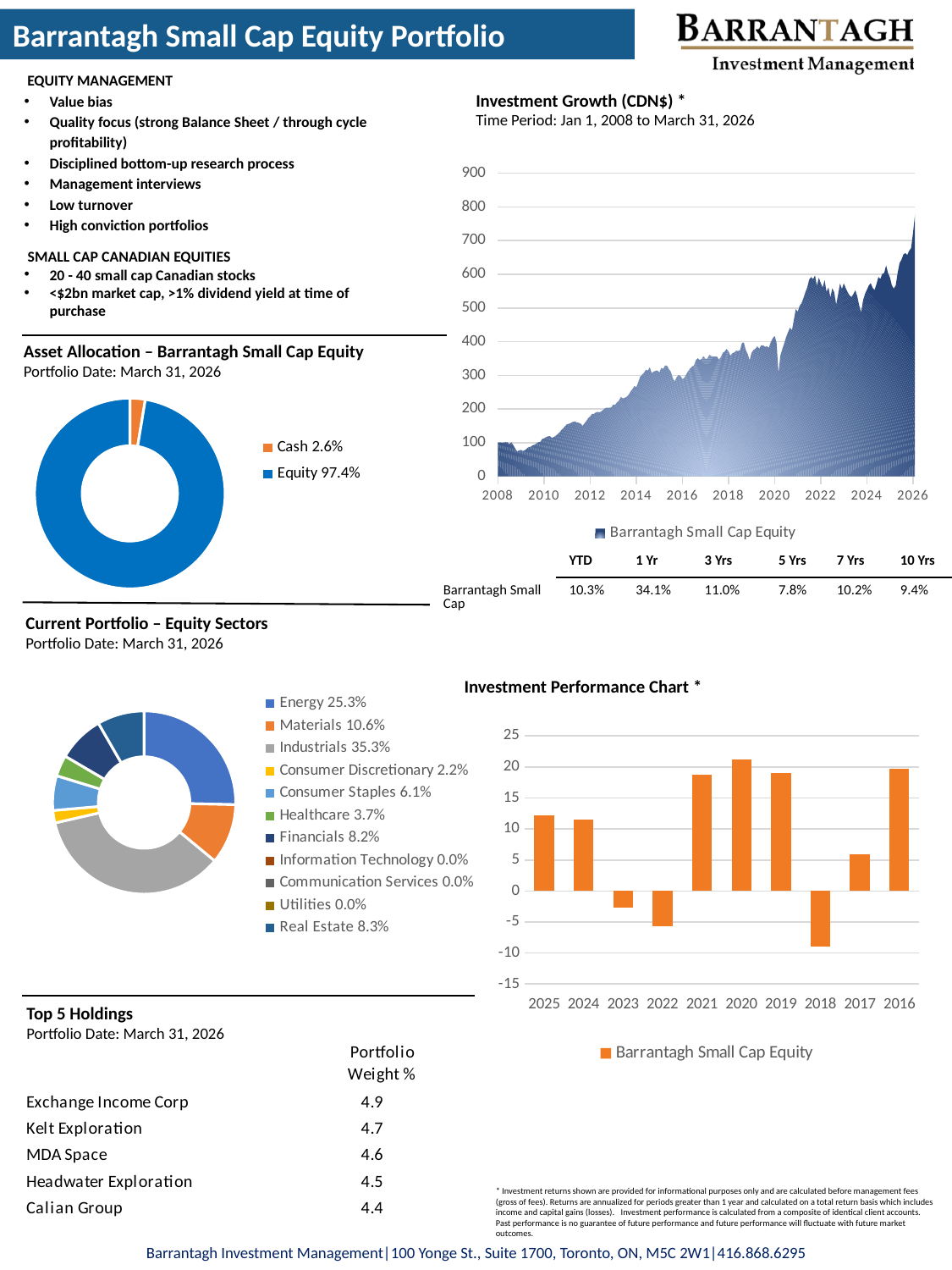
In the Asset Allocation chart, what is the value for Cash? 2.6% In the Current Portfolio – Equity Sectors chart, what is the difference between Energy and Materials? 14.7% How many sectors are listed in the legend of the Current Portfolio – Equity Sectors chart? 11 In the Asset Allocation chart, what is the value for Equity? 97.4% In the Current Portfolio – Equity Sectors chart, which sector has the largest share? Industrials In the Investment Performance Chart, which year has the highest value? 2020 What kind of chart is the Investment Performance Chart? Bar chart In the Investment Performance Chart, is the value for 2018 greater or less than -5? less In the Current Portfolio – Equity Sectors chart, what is the value for Industrials? 35.3% In the Investment Performance Chart, which year has the lowest value? 2018 In the Investment Growth (CDN$) chart, is the value at the end of the period in 2026 greater or less than 700? greater What kind of chart is the Asset Allocation chart? Donut (pie) chart